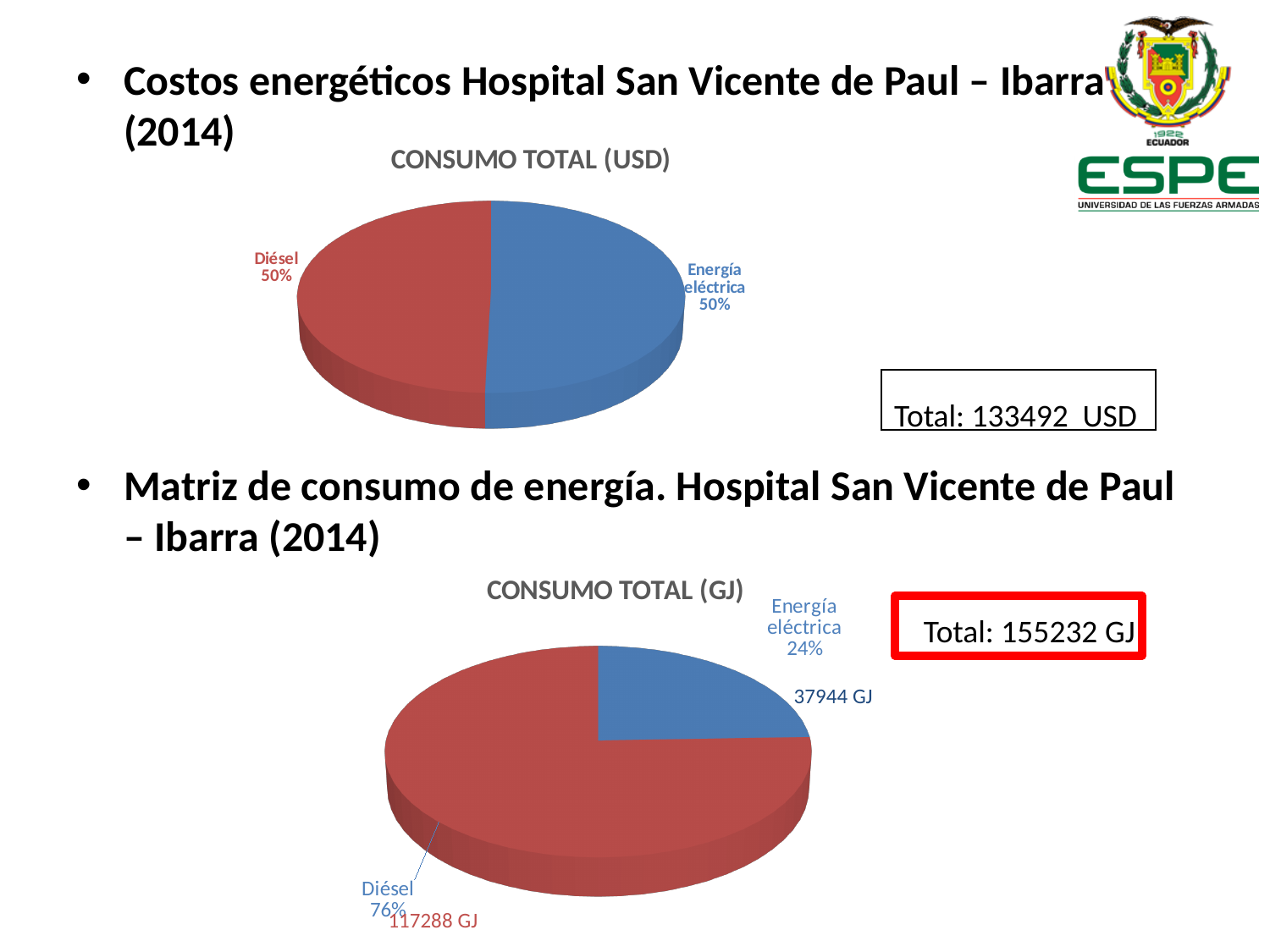
In the 'CONSUMO TOTAL (GJ)' chart, what is the difference between the Diésel and Energía eléctrica values? 79344 GJ In the 'CONSUMO TOTAL (USD)' chart, what share does Energía eléctrica have? 50% In the 'CONSUMO TOTAL (GJ)' chart, which category has the largest slice? Diésel In the 'CONSUMO TOTAL (GJ)' chart, what colour is the Diésel slice? red In the 'CONSUMO TOTAL (GJ)' chart, what is the value for Diésel? 117288 GJ In the 'CONSUMO TOTAL (GJ)' chart, what share does Energía eléctrica have? 24% In the 'CONSUMO TOTAL (USD)' chart, what share does Diésel have? 50% In the 'CONSUMO TOTAL (GJ)' chart, what is the value for Energía eléctrica? 37944 GJ What kind of chart is the 'CONSUMO TOTAL (USD)' chart? pie chart In the 'CONSUMO TOTAL (GJ)' chart, which category has the smallest slice? Energía eléctrica How many slices does the 'CONSUMO TOTAL (USD)' chart have? 2